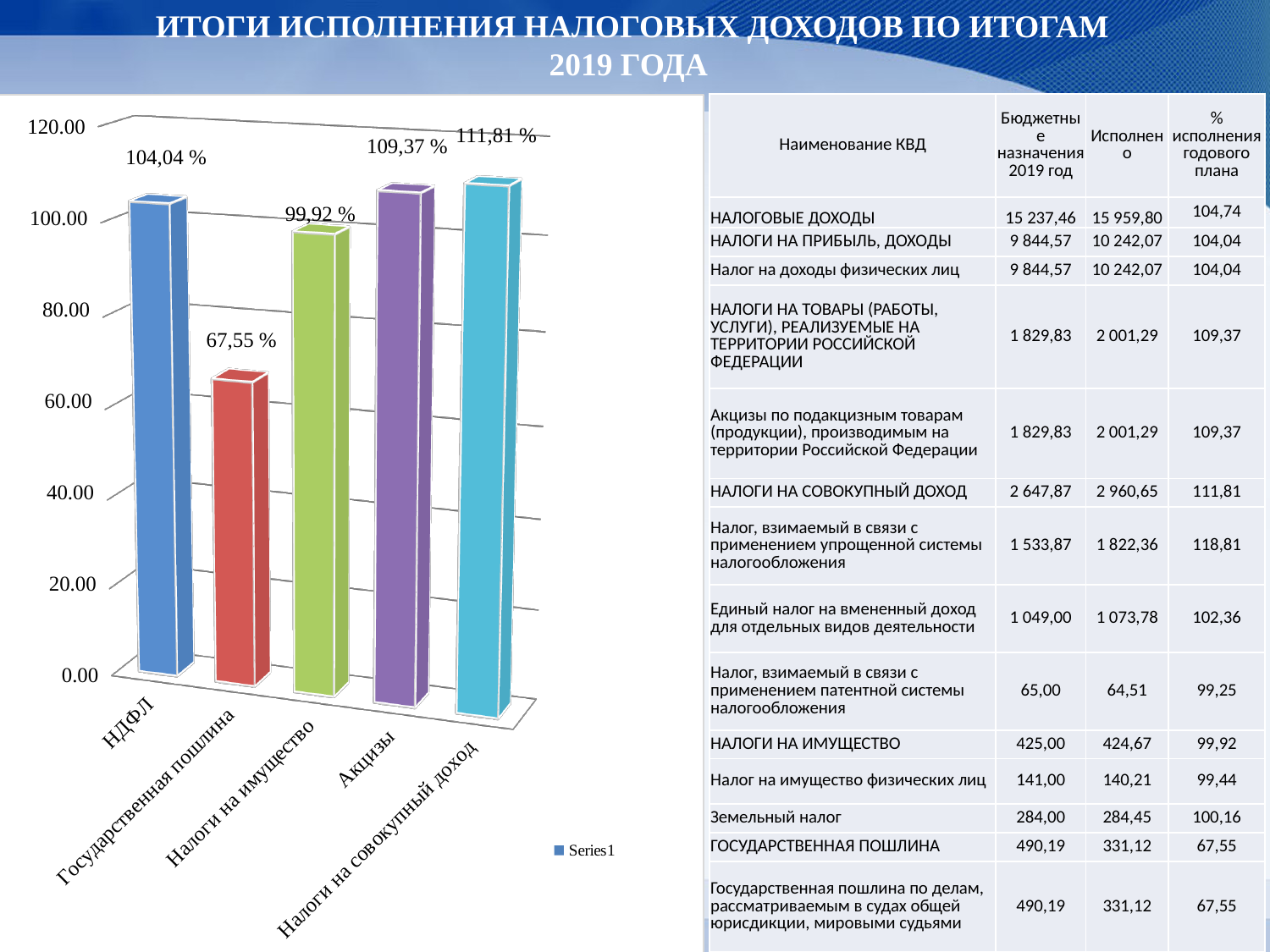
What is the value shown for Государственная пошлина? 67,55 % What is the value shown for Налоги на имущество? 99,92 % What kind of chart is shown on the slide? bar chart What is the value shown for Акцизы? 109,37 % How many categories are shown on the chart? 5 What is the value shown for Налоги на совокупный доход? 111,81 % Which category has the highest value? Налоги на совокупный доход Is the value for Государственная пошлина greater or less than 80.00? less What is the value shown for НДФЛ? 104,04 % Which is larger, the value for НДФЛ or the value for Налоги на имущество? НДФЛ What is the difference between the values for Акцизы and НДФЛ? 5,33 % Which category has the lowest value? Государственная пошлина